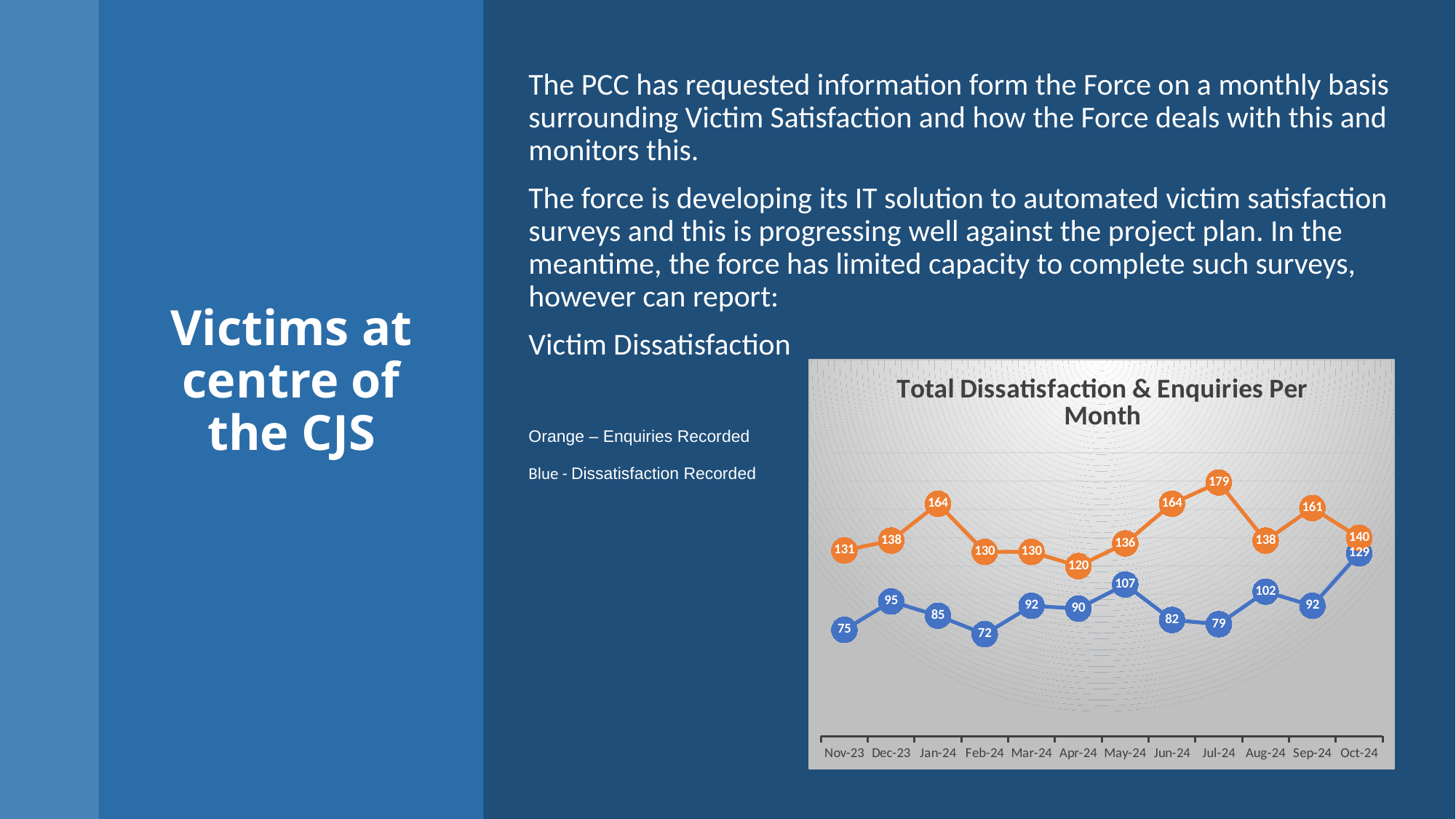
What type of chart is shown on the slide? Line chart What is the title of the chart? Total Dissatisfaction & Enquiries Per Month What is the difference between Enquiries Recorded and Dissatisfaction Recorded in Oct-24? 11 What is the value of Dissatisfaction Recorded (blue line) for Nov-23? 75 Does Enquiries Recorded (orange line) rise or fall from Jul-24 to Aug-24? Fall In which month is Dissatisfaction Recorded (blue line) at its highest? Oct-24 How many months are plotted along the x axis of the chart? 12 How many data series are plotted in the chart? 2 In which month is Enquiries Recorded (orange line) at its lowest? Apr-24 What is the value of Dissatisfaction Recorded (blue line) for Feb-24? 72 Which is larger: Dissatisfaction Recorded in May-24 or in Jun-24? May-24 What is the value of Enquiries Recorded (orange line) for Jul-24? 179